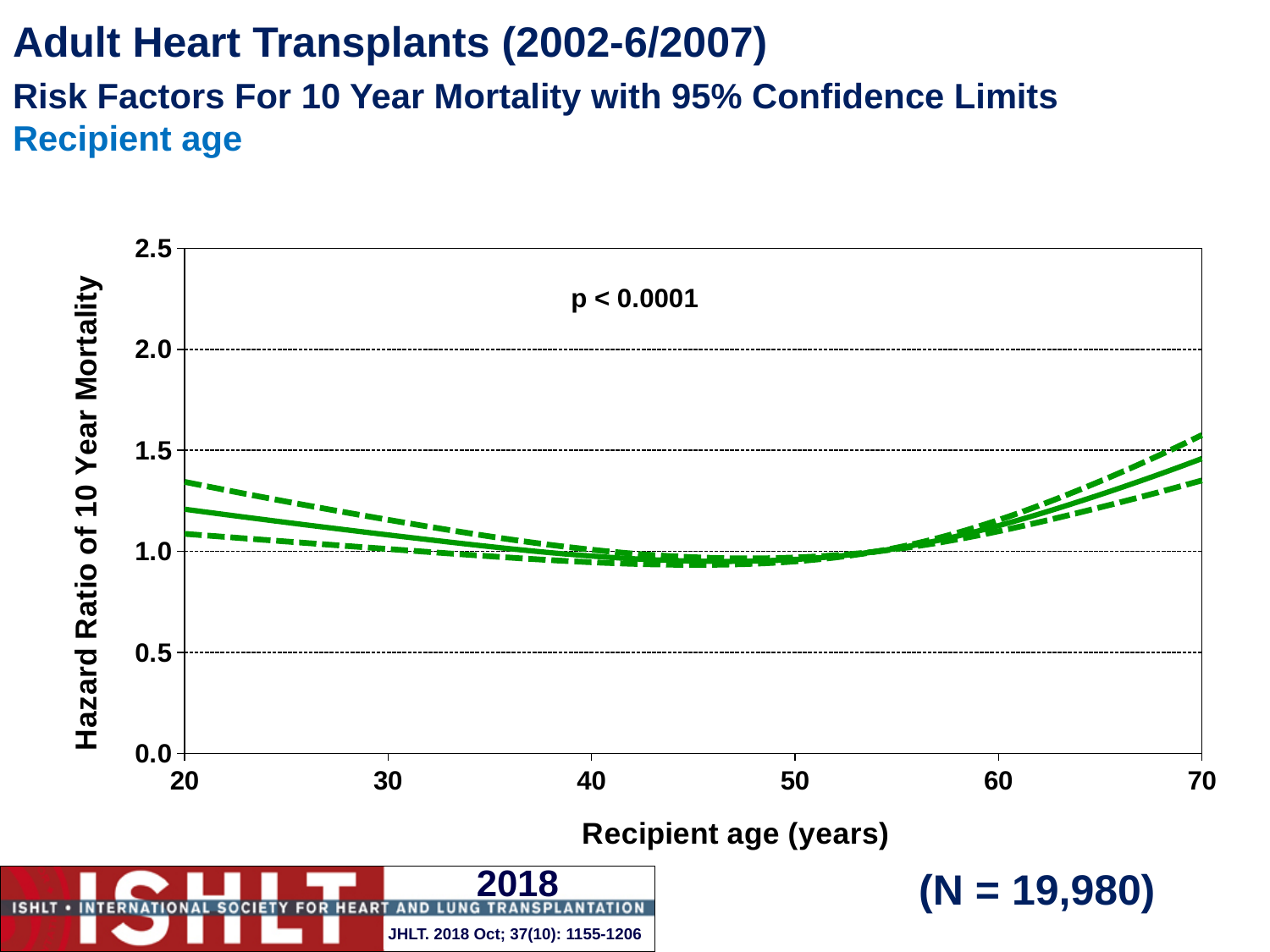
Does the hazard ratio rise or fall as recipient age increases from 50 to 70 years? rises Is the hazard ratio (solid line) at recipient age 20 greater or less than 1.0? greater Does the hazard ratio rise or fall as recipient age increases from 20 to 45 years? falls What sample size (N) is shown on the slide? N = 19,980 Which has the higher hazard ratio on the solid line: recipient age 20 or recipient age 70? recipient age 70 Is the hazard ratio (solid line) at recipient age 45 greater or less than 1.5? less What p-value is shown on the chart? p < 0.0001 Is the hazard ratio (solid line) at recipient age 70 greater or less than 1.0? greater What kind of chart is shown on the slide? line chart How many lines are plotted on the chart? 3